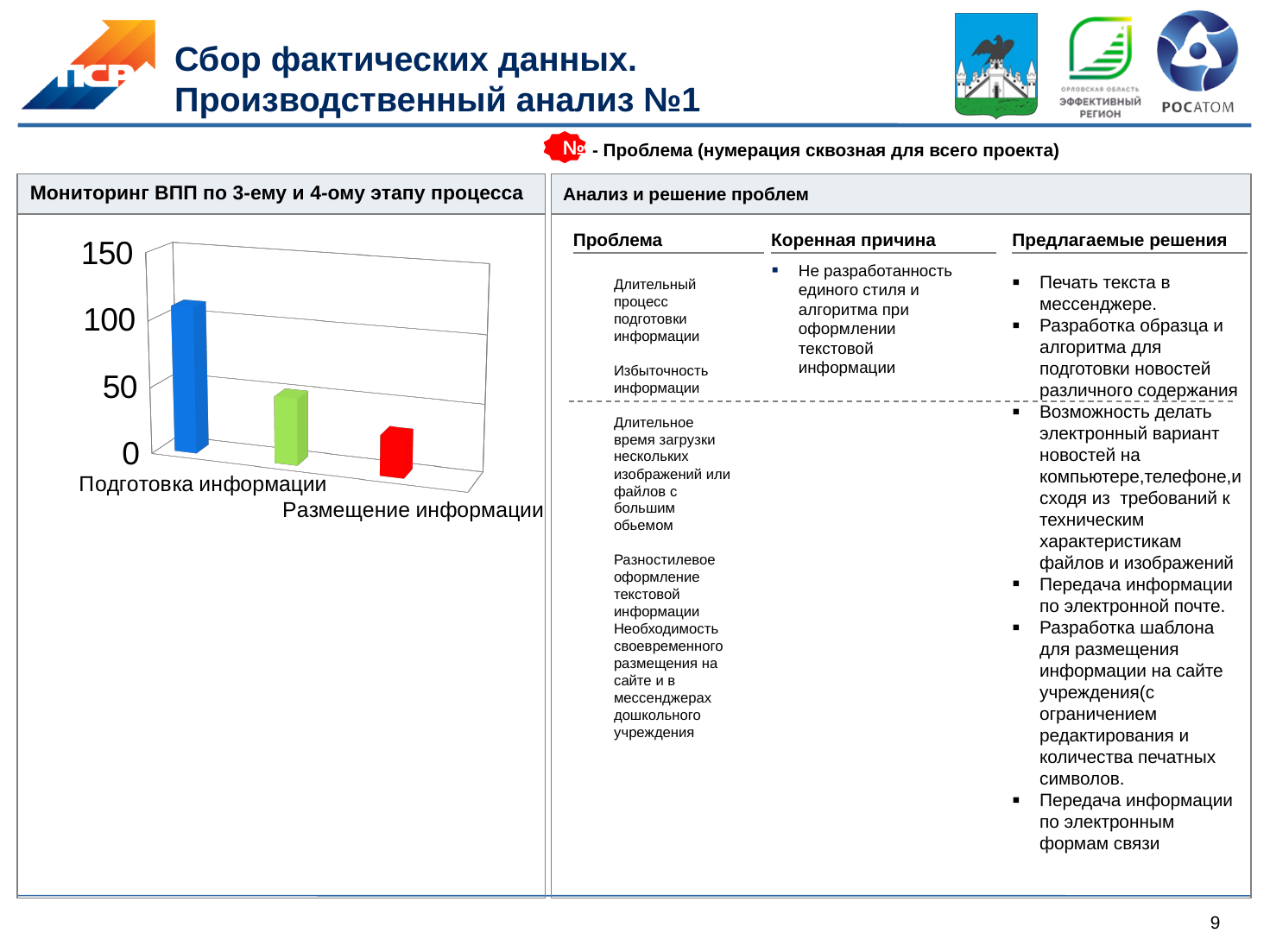
Is the value of the blue bar (Подготовка информации) greater or less than 150? less Is the value of the red bar greater or less than 50? less What is the highest value shown on the vertical axis of the chart? 150 What kind of chart is shown in the "Мониторинг ВПП по 3-ему и 4-ому этапу процесса" panel? bar chart Is the value of the green bar greater or less than 100? less Which bar is the shortest in the chart? the red bar Do the bar values rise or fall from left to right across the chart? fall Which bar is the tallest in the chart? the blue bar (Подготовка информации) How many bars are plotted in the chart? 3 Which is larger, the blue bar or the green bar? the blue bar